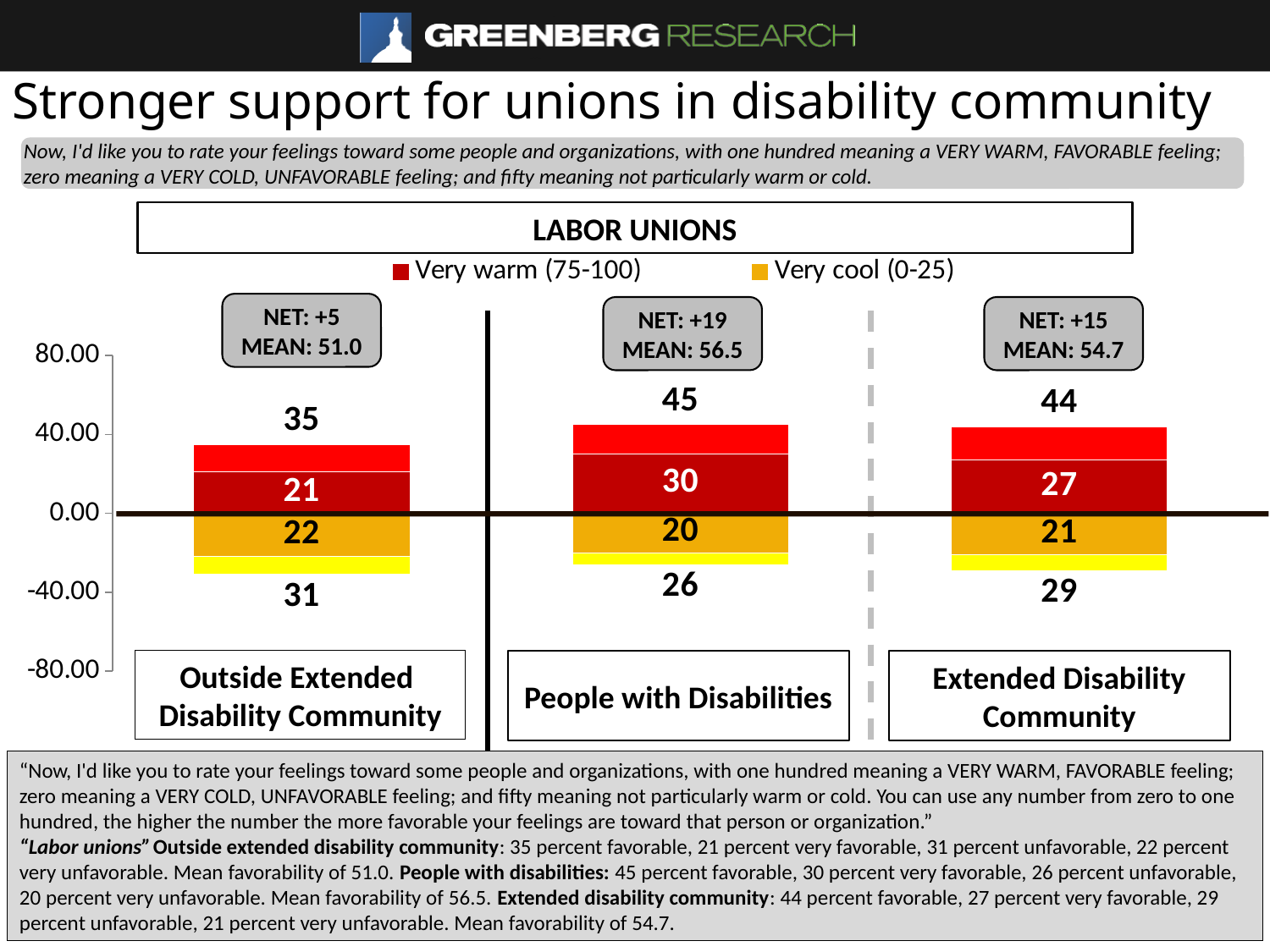
Which group has the highest favorable (warm) percentage? People with Disabilities What kind of chart is shown? Bar chart Which is larger: the very warm value for People with Disabilities or for the Extended Disability Community? People with Disabilities What is the difference between the favorable percentage for People with Disabilities and for the Outside Extended Disability Community? 10 What is the very warm (75-100) value for the Extended Disability Community? 27 Which group has the lowest favorable (warm) percentage? Outside Extended Disability Community What is the unfavorable (cool) percentage for the Outside Extended Disability Community? 31 How many series does the legend list? 2 What is the NET value shown for the Extended Disability Community? +15 How many groups are shown on the chart? 3 What is the favorable (warm) percentage for People with Disabilities? 45 What is the very cool (0-25) value for People with Disabilities? 20